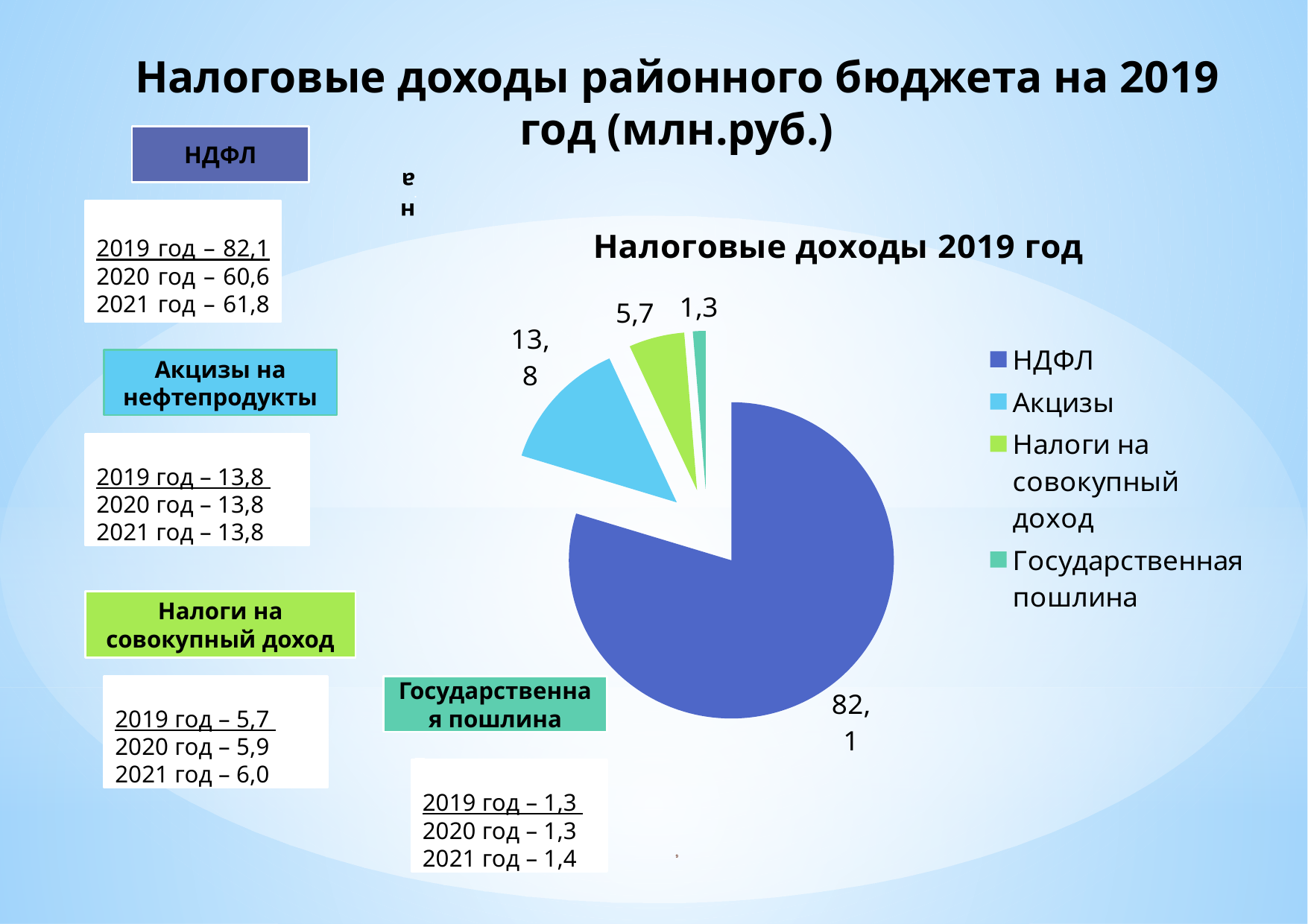
Which category has the smallest slice in the pie chart? Государственная пошлина What type of chart is shown on the slide? pie chart Which is larger in the pie chart: Акцизы or Налоги на совокупный доход? Акцизы What is the value of the Государственная пошлина slice in the pie chart? 1,3 How many slices does the pie chart have? 4 How many entries does the chart legend list? 4 What is the value of the НДФЛ slice in the pie chart? 82,1 What is the difference between the НДФЛ value and the Акцизы value in the pie chart? 68,3 What is the value of the Налоги на совокупный доход slice in the pie chart? 5,7 Which category has the largest slice in the pie chart? НДФЛ What is the value of the Акцизы slice in the pie chart? 13,8 What is the title of the chart? Налоговые доходы 2019 год